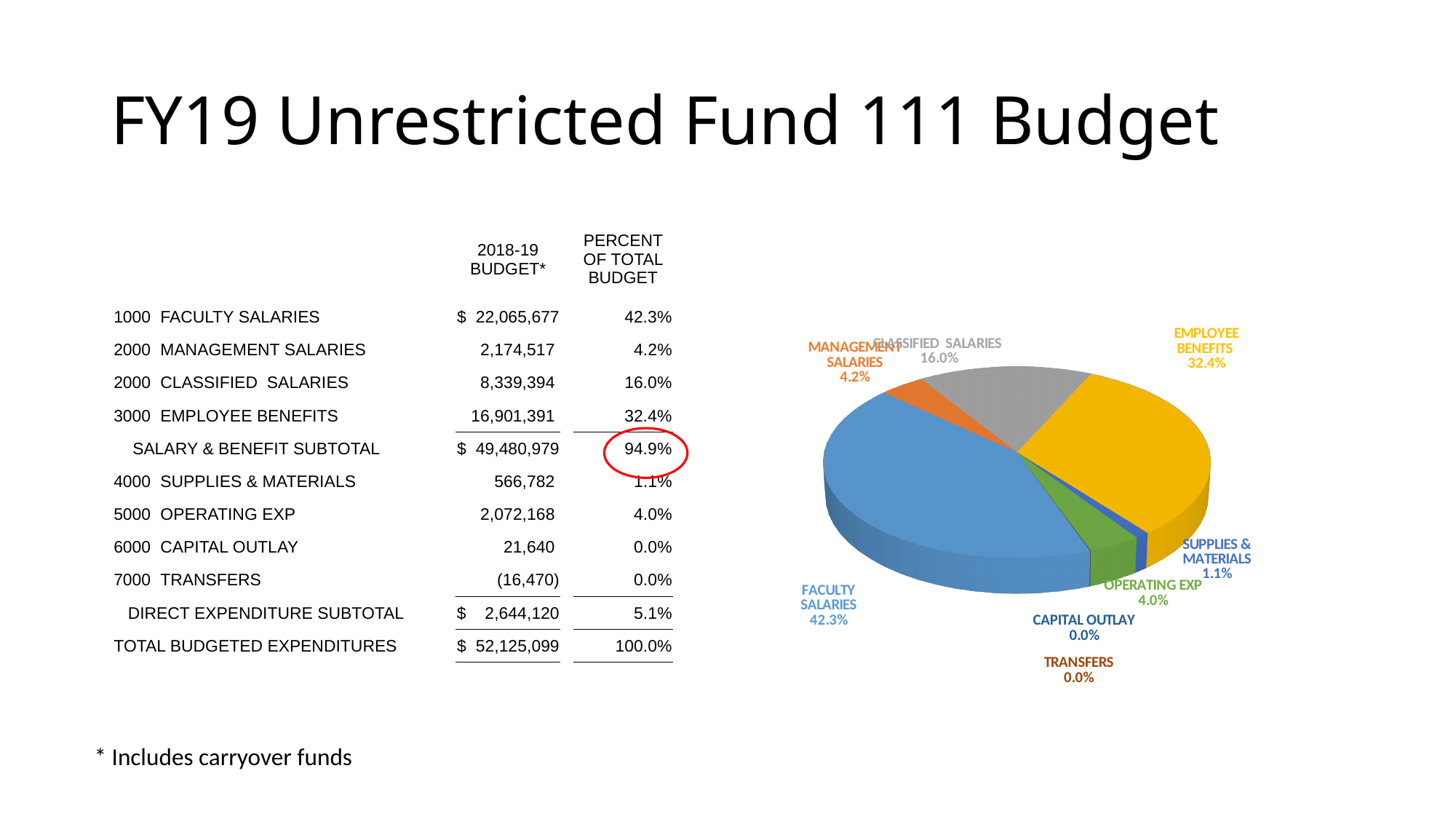
How many categories are labelled on the pie chart? 8 What share of the pie chart does EMPLOYEE BENEFITS represent? 32.4% Which category has the largest slice in the pie chart? FACULTY SALARIES What is the difference in percentage points between the FACULTY SALARIES slice and the EMPLOYEE BENEFITS slice? 9.9 What colour is the FACULTY SALARIES slice in the pie chart? blue What kind of chart is shown on the slide? pie chart What percentage is shown for CAPITAL OUTLAY in the pie chart? 0.0% What share of the pie chart does FACULTY SALARIES represent? 42.3% What share of the pie chart does SUPPLIES & MATERIALS represent? 1.1% Which is larger in the pie chart, EMPLOYEE BENEFITS or CLASSIFIED SALARIES? EMPLOYEE BENEFITS